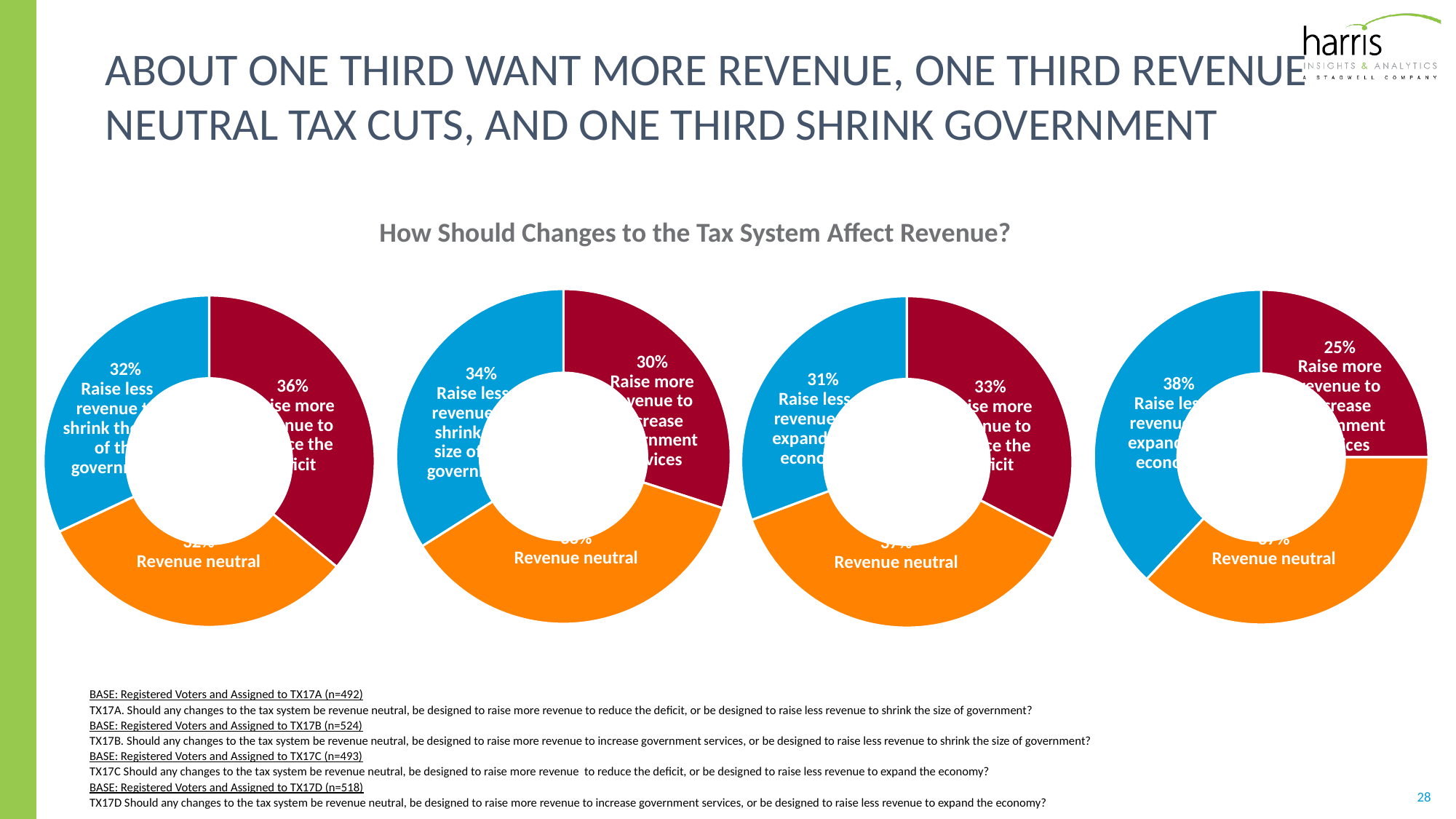
What is the shared title above the charts? How Should Changes to the Tax System Affect Revenue? In the second donut chart from the left, what percentage want to raise less revenue to shrink the size of government? 34% In the leftmost donut chart, what percentage want to raise more revenue to reduce the deficit? 36% What type of chart is used on this slide? Donut (pie) chart How many donut charts are shown on the slide? 4 In the rightmost donut chart, what percentage want to raise less revenue to expand the economy? 38% In the leftmost donut chart, which is larger: raising more revenue to reduce the deficit or raising less revenue to shrink the size of the government? Raise more revenue to reduce the deficit In the second donut chart from the left, what percentage want to raise more revenue to increase government services? 30% In the third donut chart from the left, what percentage want to raise more revenue to reduce the deficit? 33% In the rightmost donut chart, which option has the smallest share? Raise more revenue to increase government services In the leftmost donut chart, what percentage want to raise less revenue to shrink the size of the government? 32% In the rightmost donut chart, what is the difference in percentage points between raising less revenue to expand the economy and raising more revenue to increase government services? 13 percentage points